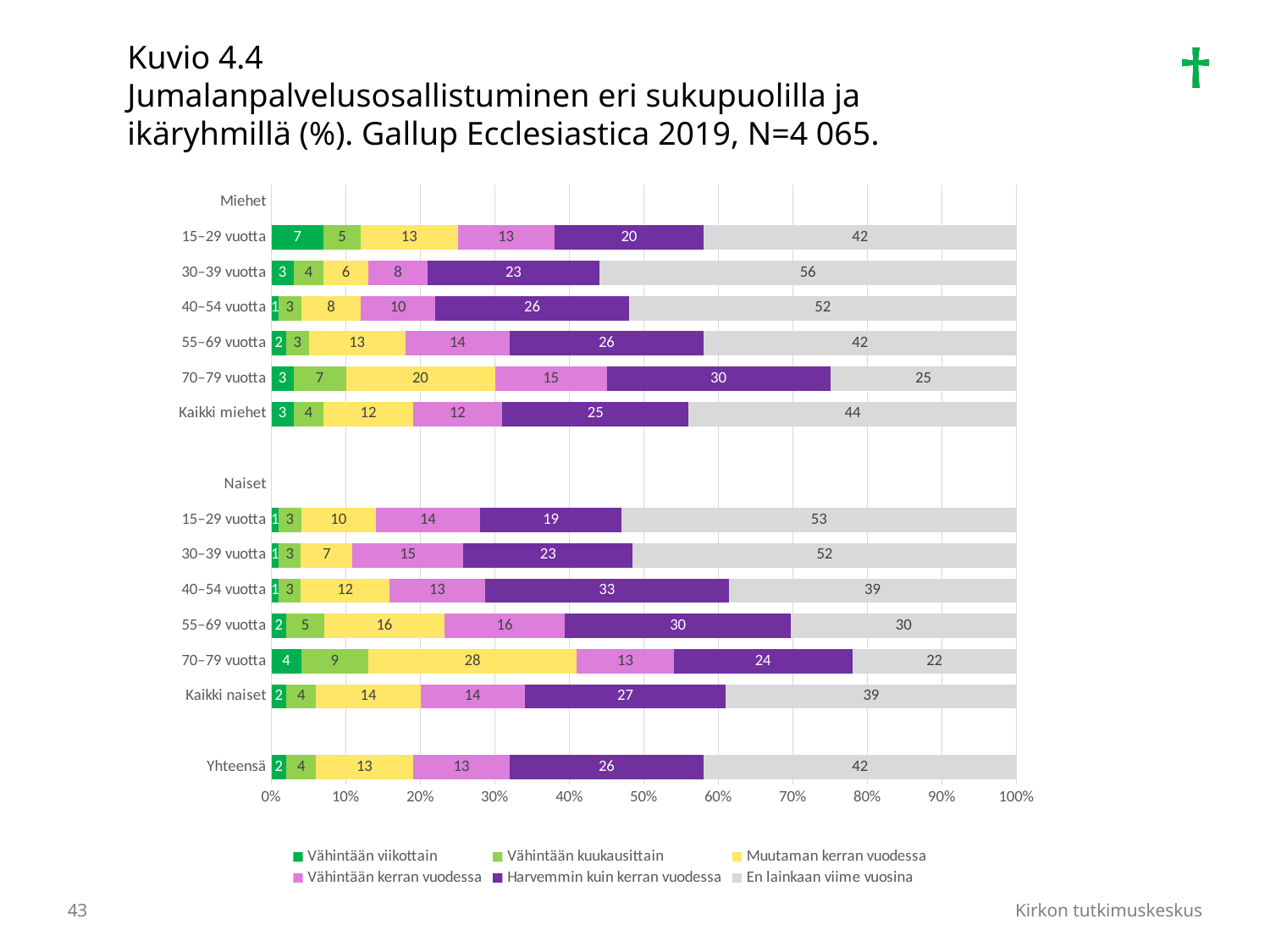
What is the value of "En lainkaan viime vuosina" for Yhteensä? 42 What is the difference between the "En lainkaan viime vuosina" values for Kaikki miehet and Kaikki naiset? 5 What is the value of "Harvemmin kuin kerran vuodessa" for Naiset 40–54 vuotta? 33 What type of chart is shown on the slide? stacked bar chart Which is larger: the "Harvemmin kuin kerran vuodessa" value for Miehet 70–79 vuotta or for Naiset 70–79 vuotta? Miehet 70–79 vuotta What is the total of the "Vähintään viikottain" and "Vähintään kuukausittain" values for Naiset 70–79 vuotta? 13 How many series does the legend list? 6 What is the value of "Muutaman kerran vuodessa" for Naiset 70–79 vuotta? 28 What is the value of "En lainkaan viime vuosina" for Miehet 30–39 vuotta? 56 What is the value of "Vähintään viikottain" for Miehet 15–29 vuotta? 7 Among the Naiset age groups, which has the lowest value for "En lainkaan viime vuosina"? 70–79 vuotta Among the Miehet age groups, which has the highest value for "En lainkaan viime vuosina"? 30–39 vuotta